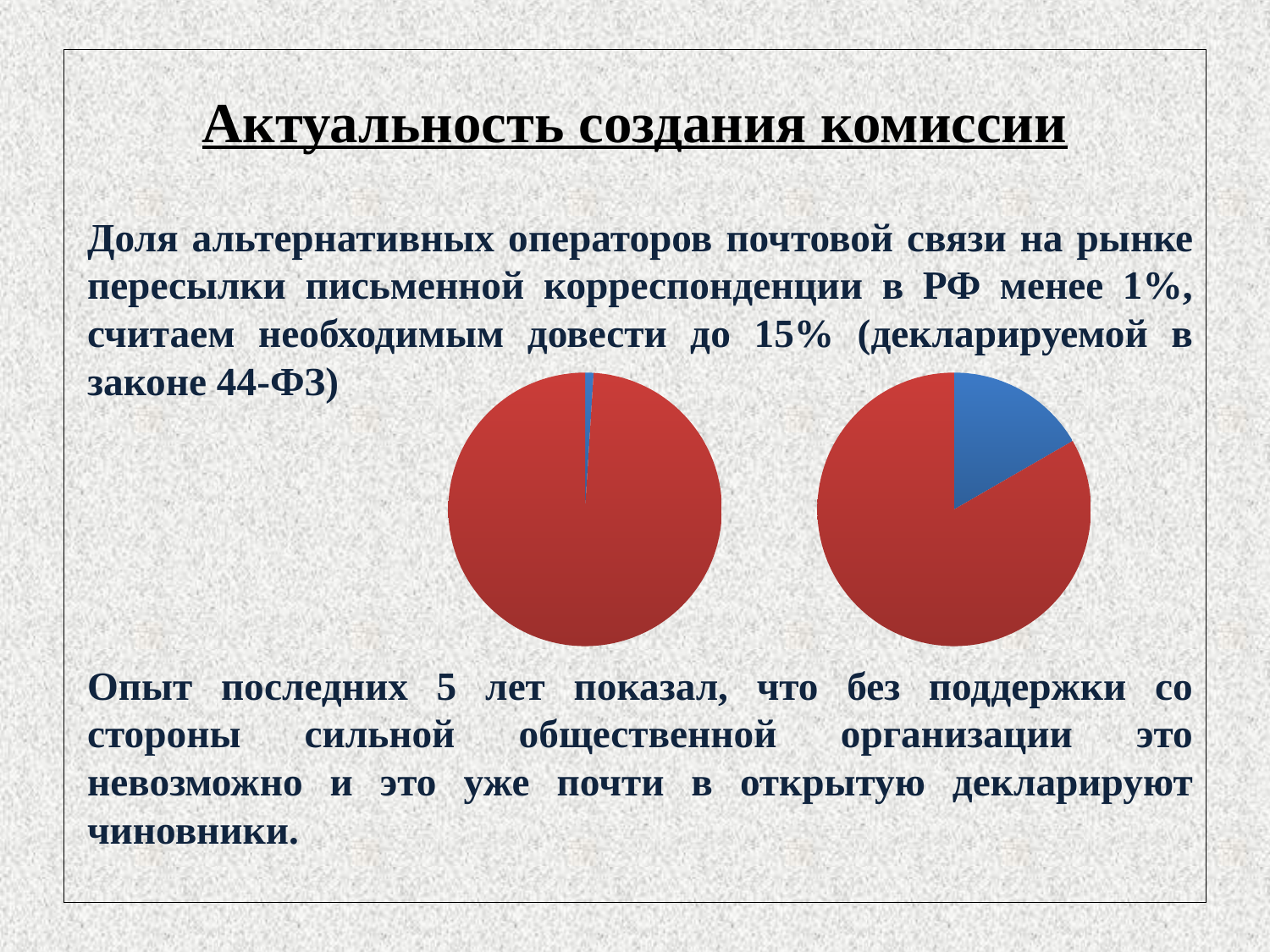
How many slices does the left pie chart have? 2 Which pie chart has the larger blue slice, the left one or the right one? the right one What two colours are used for the slices in the pie charts? red and blue What kind of chart is the left chart on the slide? pie chart In the right pie chart, which slice is larger, the red one or the blue one? red How many pie charts are shown on the slide? 2 How many slices does the right pie chart have? 2 What kind of chart is the right chart on the slide? pie chart In the left pie chart, which slice is larger, the red one or the blue one? red